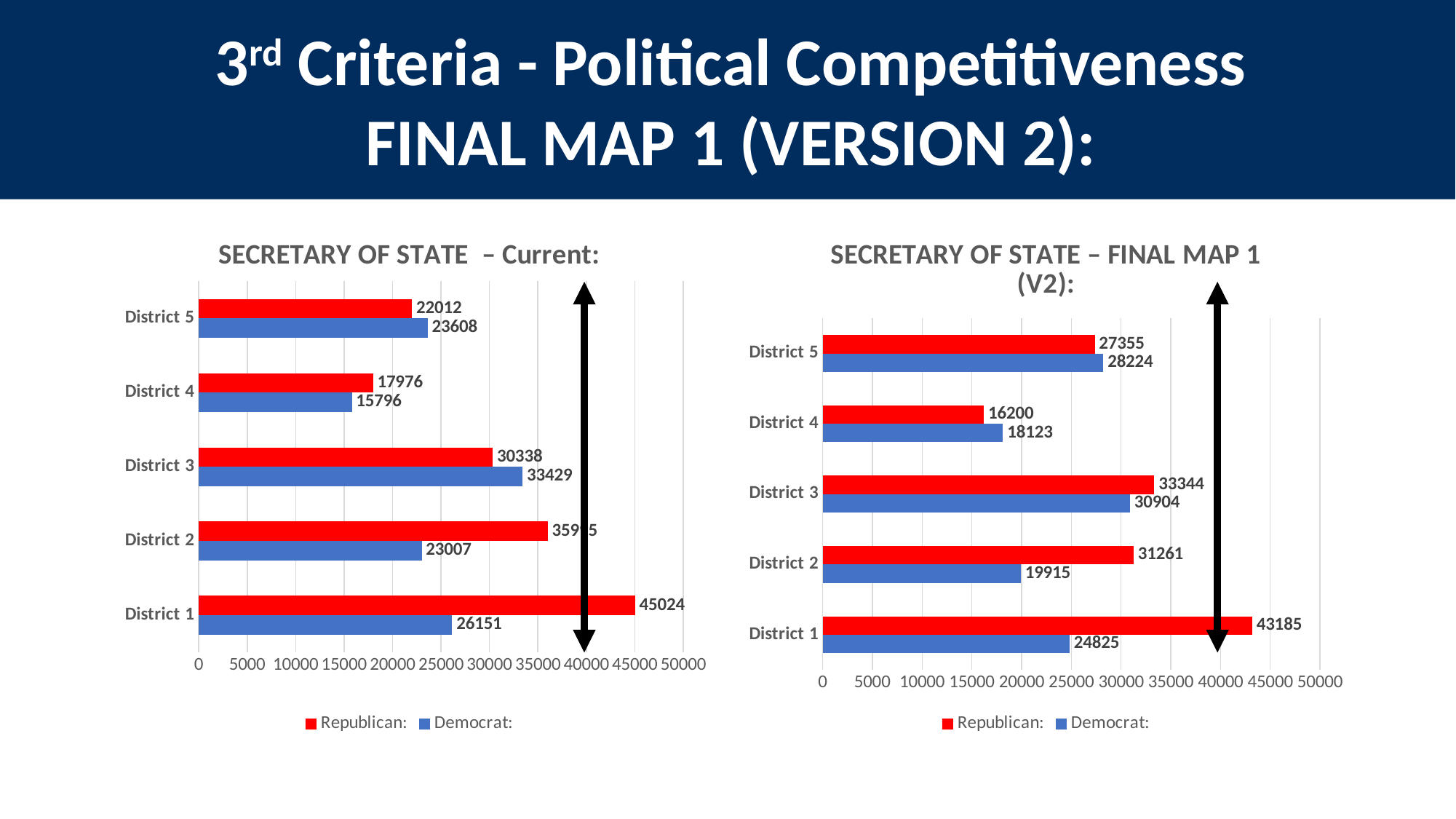
In the 'SECRETARY OF STATE – FINAL MAP 1 (V2)' chart, is the Republican or Democrat value larger for District 3? Republican How many districts are shown in the 'SECRETARY OF STATE – FINAL MAP 1 (V2)' chart? 5 In the 'SECRETARY OF STATE – FINAL MAP 1 (V2)' chart, what is the Democrat value for District 2? 19915 In the 'SECRETARY OF STATE – FINAL MAP 1 (V2)' chart, which district has the highest Republican value? District 1 In the 'SECRETARY OF STATE – Current' chart, is the Republican value for District 1 greater or less than 40000? greater How many series does the legend of the 'SECRETARY OF STATE – Current' chart list? 2 In the 'SECRETARY OF STATE – Current' chart, which district has the lowest Democrat value? District 4 In the 'SECRETARY OF STATE – Current' chart, what is the Republican value for District 1? 45024 In the 'SECRETARY OF STATE – FINAL MAP 1 (V2)' chart, what is the Republican value for District 4? 16200 In the 'SECRETARY OF STATE – Current' chart, what is the Democrat value for District 3? 33429 In the 'SECRETARY OF STATE – FINAL MAP 1 (V2)' chart, what is the difference between the Republican and Democrat values for District 1? 18360 In the 'SECRETARY OF STATE – Current' chart, what is the difference between the Democrat and Republican values for District 5? 1596